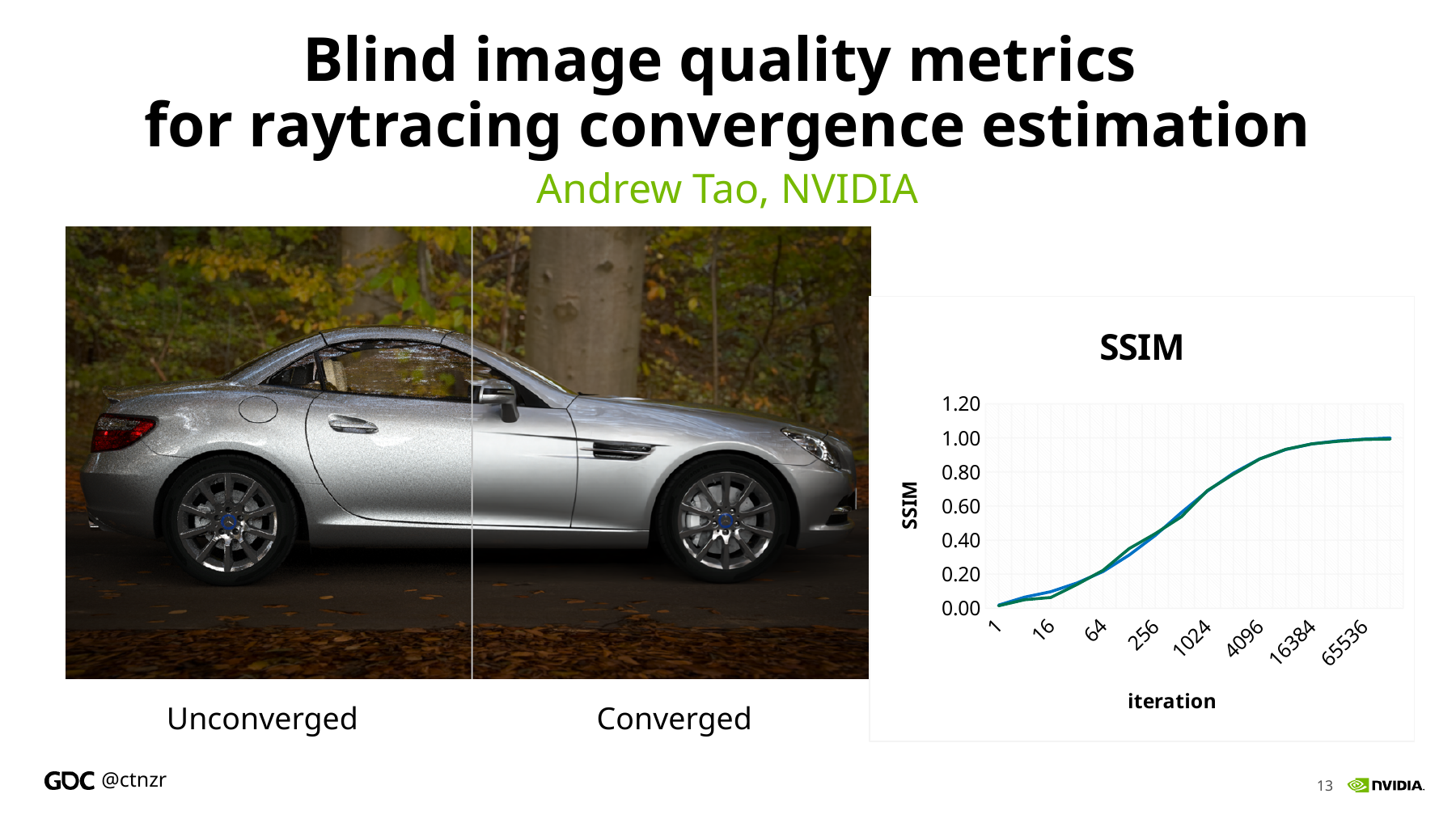
What kind of chart is shown on the slide? line chart How many iteration tick labels are shown on the x axis of the chart? 8 Is the SSIM value at iteration 1 greater or less than 0.20? less Is the SSIM value at iteration 256 greater or less than 0.60? less Which iteration has the highest SSIM value, 1 or 65536? 65536 What is the label of the x axis of the chart? iteration What is the title of the chart? SSIM What is the highest value shown on the y axis of the chart? 1.20 Do the SSIM values rise or fall as the iteration count increases along the x axis? rise Is the SSIM value at iteration 64 greater or less than 0.40? less